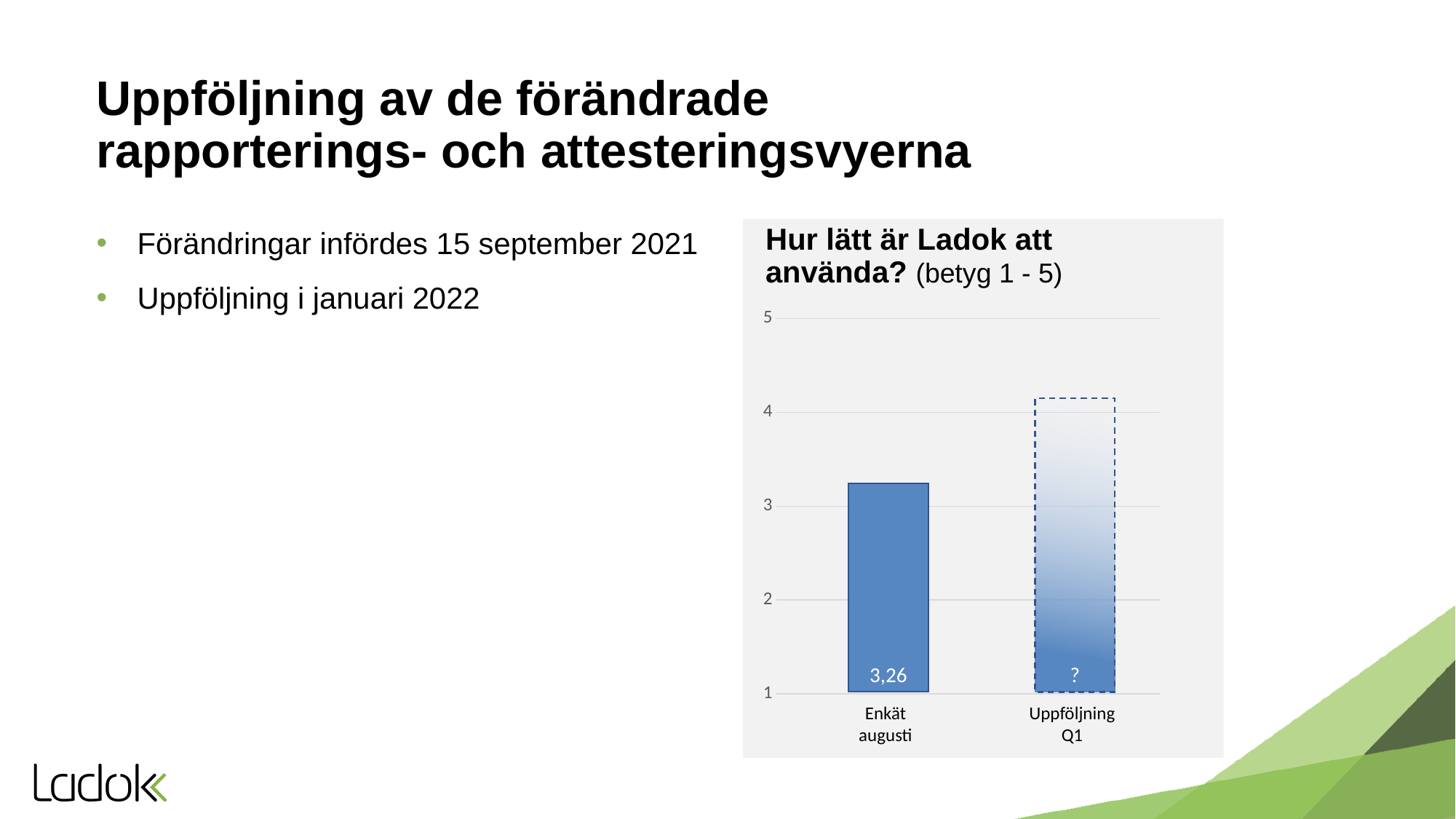
What kind of chart is shown on the slide? Bar chart Which category's bar is drawn with a dashed outline? Uppföljning Q1 Is the value for Enkät augusti greater or less than 4? less What label is printed on the Uppföljning Q1 bar? ? Is the value for Enkät augusti greater or less than 3? greater How many categories are shown on the x axis? 2 What is the title of the chart? Hur lätt är Ladok att använda? (betyg 1 - 5) What is the highest value shown on the y axis? 5 What value is shown for Enkät augusti? 3,26